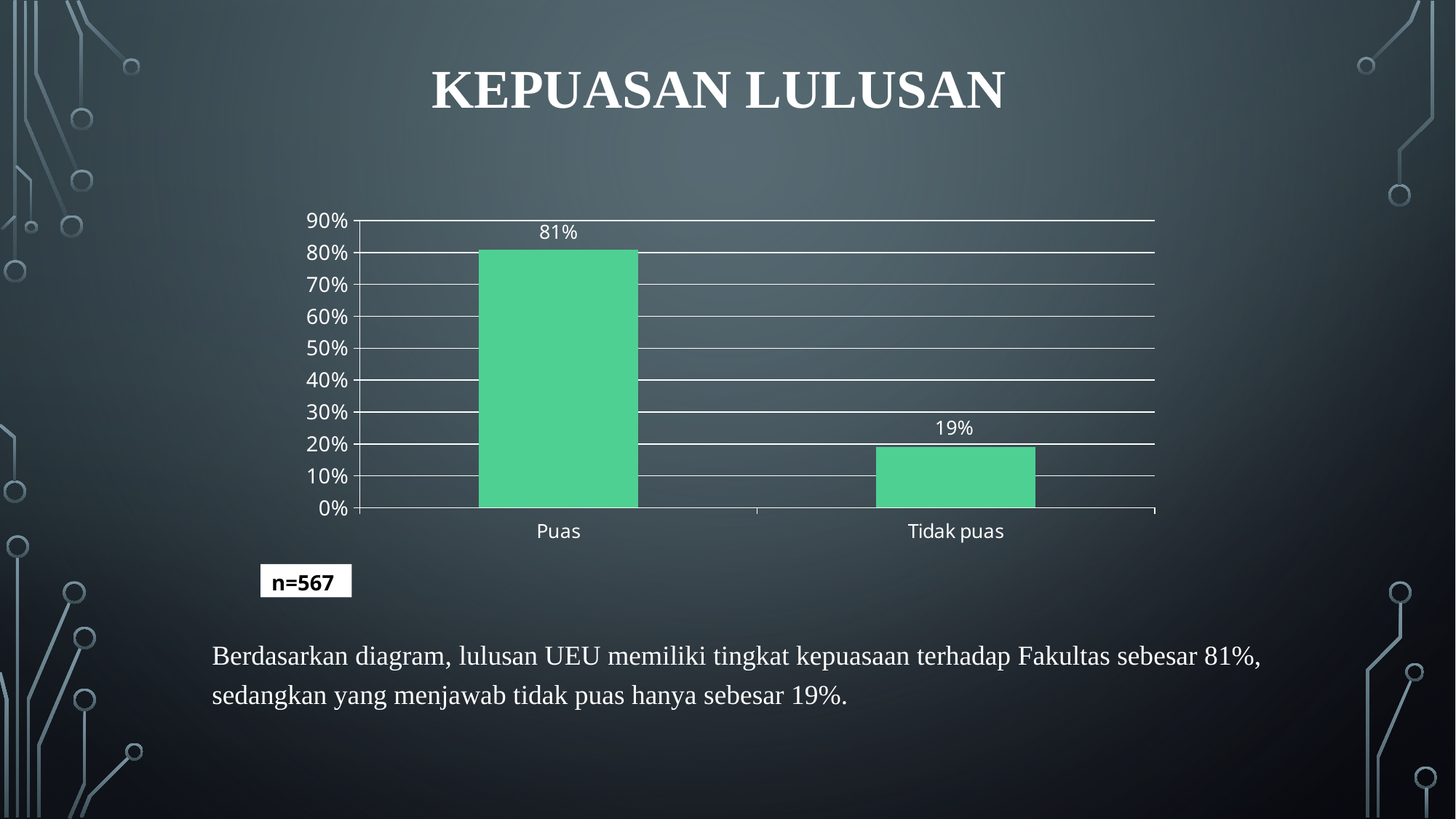
Is the value for Tidak puas greater or less than 20%? less What kind of chart is shown on the slide? bar chart Is the value for Puas greater or less than 80%? greater What is the value for Puas? 81% What is the value for Tidak puas? 19% Which category has the highest value? Puas What is the difference between the values for Puas and Tidak puas? 62% How many categories are shown on the x axis? 2 Which category has the lowest value? Tidak puas What sample size (n) is shown below the chart? n=567 What is the title of the slide containing the chart? KEPUASAN LULUSAN Which is larger, the value for Puas or the value for Tidak puas? Puas